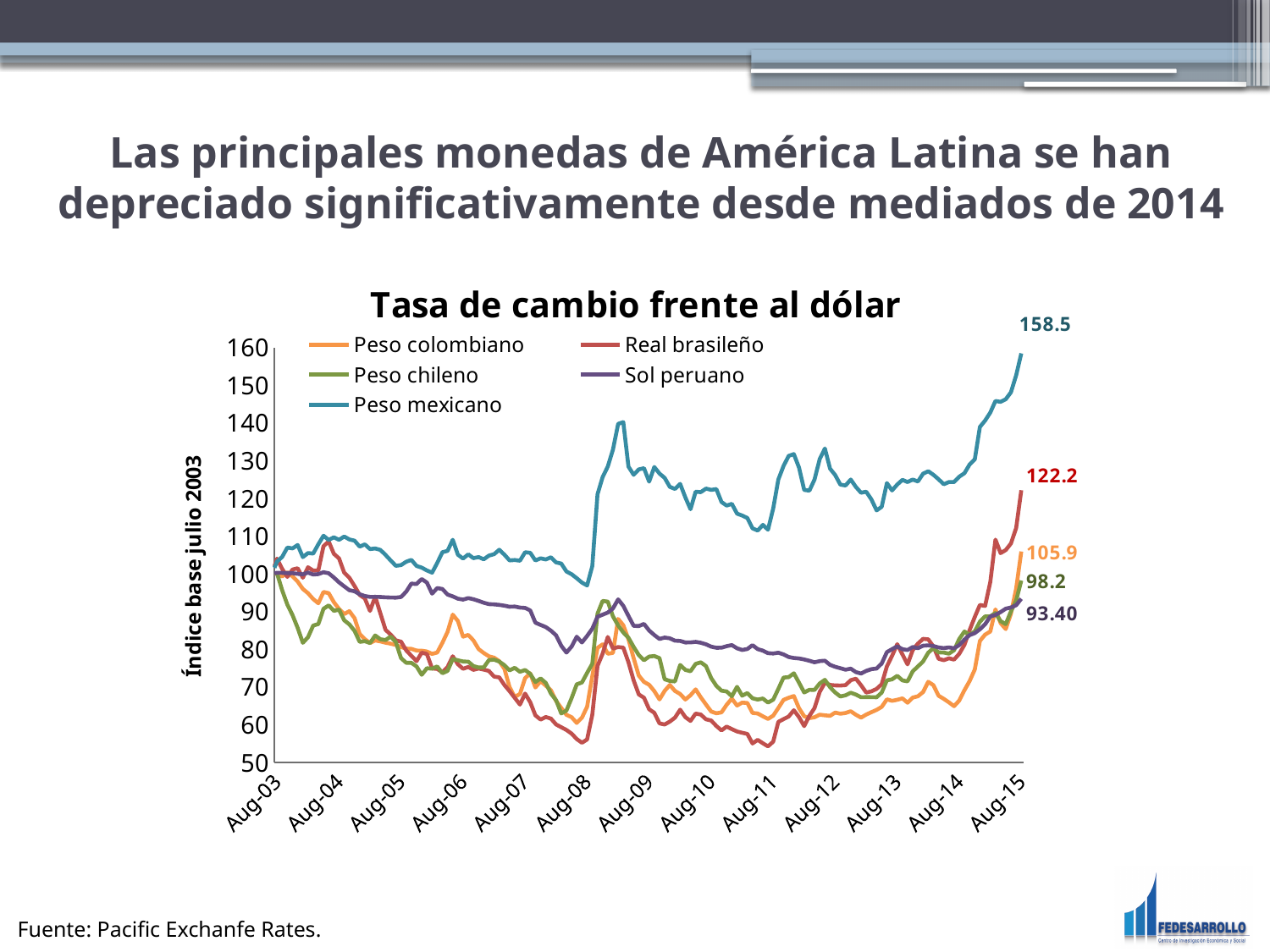
What is the label on the vertical axis? Índice base julio 2003 How many series does the chart legend list? 5 What is the final labelled value for the Peso mexicano series? 158.5 What type of chart is shown on the slide? line chart What is the final labelled value for the Sol peruano series? 93.40 Which currency has the highest labelled value at the end of the series? Peso mexicano What is the difference between the final labelled values of the Peso mexicano and the Real brasileño? 36.3 What is the title of the chart? Tasa de cambio frente al dólar At the end of the series, which is larger: the labelled value for the Peso colombiano or the Peso chileno? Peso colombiano Which currency has the lowest labelled value at the end of the series? Sol peruano What is the final labelled value for the Real brasileño series? 122.2 What is the final labelled value for the Peso colombiano series? 105.9